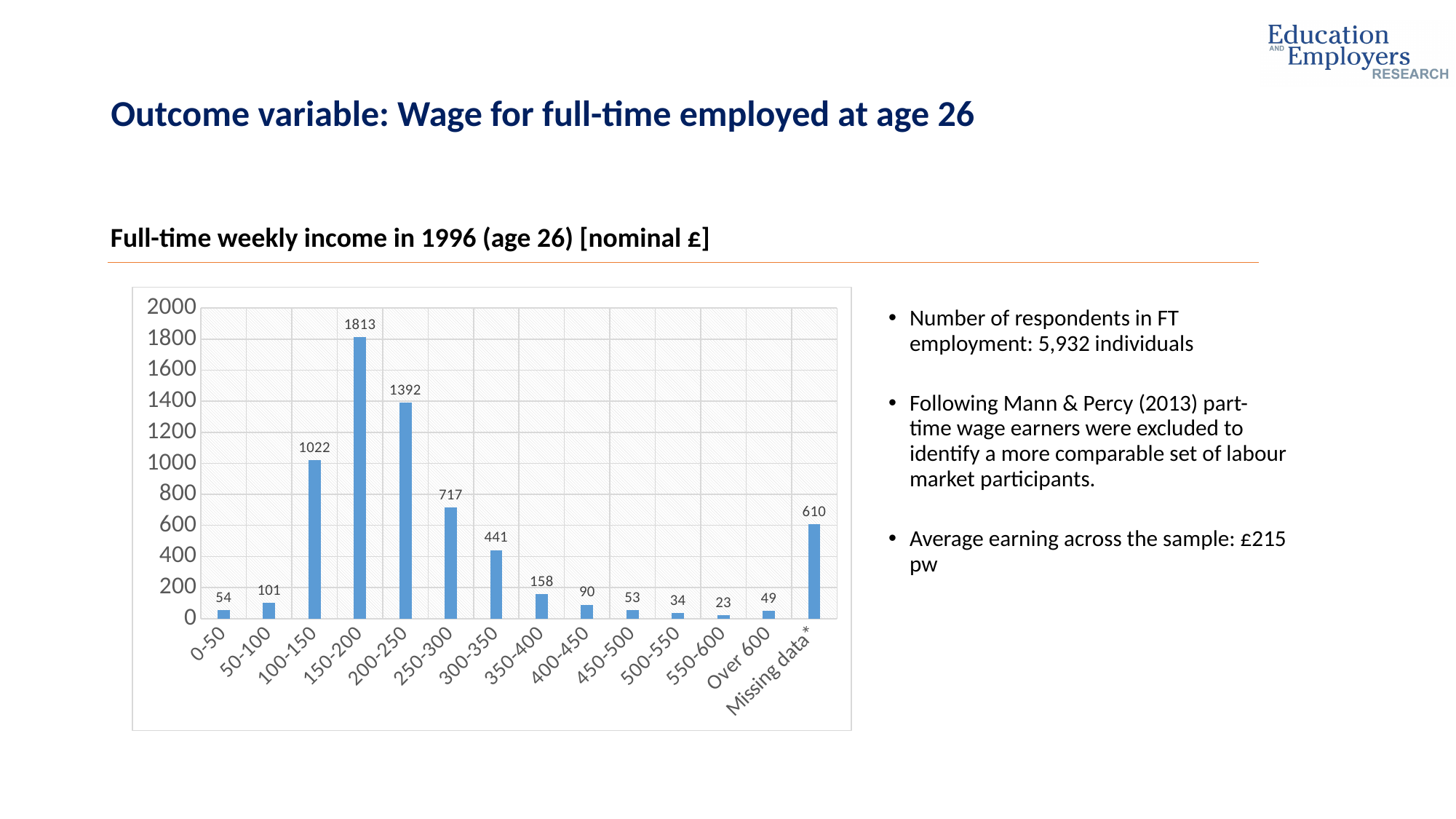
How many categories are shown on the x axis? 14 Is the value for 200-250 greater or less than 1200? greater What is the difference between the values for 150-200 and 200-250? 421 Which category has the highest value? 150-200 Do the values rise or fall from the 150-200 category to the Over 600 category? fall What kind of chart is shown on the slide? bar chart What is the value for the 350-400 category? 158 What is the value for the 150-200 category? 1813 What is the title of the chart? Full-time weekly income in 1996 (age 26) [nominal £] Which category has the lowest value? 550-600 Which is larger, the value for 100-150 or the value for 250-300? 100-150 What is the value for the Missing data* category? 610